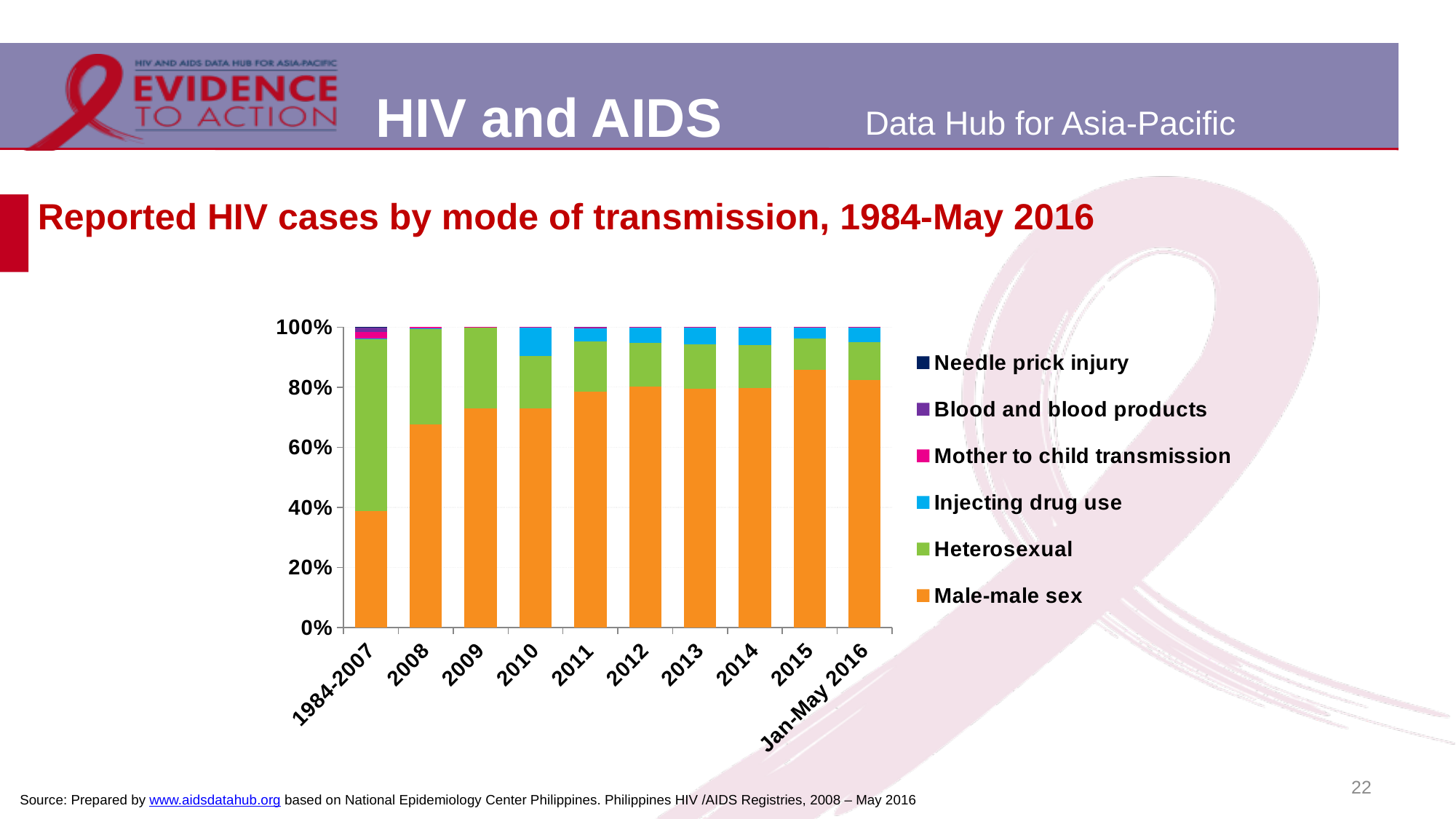
How many time periods are shown on the x axis of the chart? 10 Which period has a larger Male-male sex share, 1984-2007 or 2015? 2015 Which period has the smallest Male-male sex share? 1984-2007 What kind of chart is shown on the slide? Stacked bar chart What is the title of the chart on the slide? Reported HIV cases by mode of transmission, 1984-May 2016 Is the Male-male sex share for 2015 greater or less than 80%? greater Is the Male-male sex share for 1984-2007 greater or less than 60%? less How many series does the chart's legend list? 6 Which series is shown in orange in the chart's legend? Male-male sex Is the Male-male sex share for 2008 greater or less than 60%? greater Does the Male-male sex share generally rise or fall from 1984-2007 to Jan-May 2016? rise